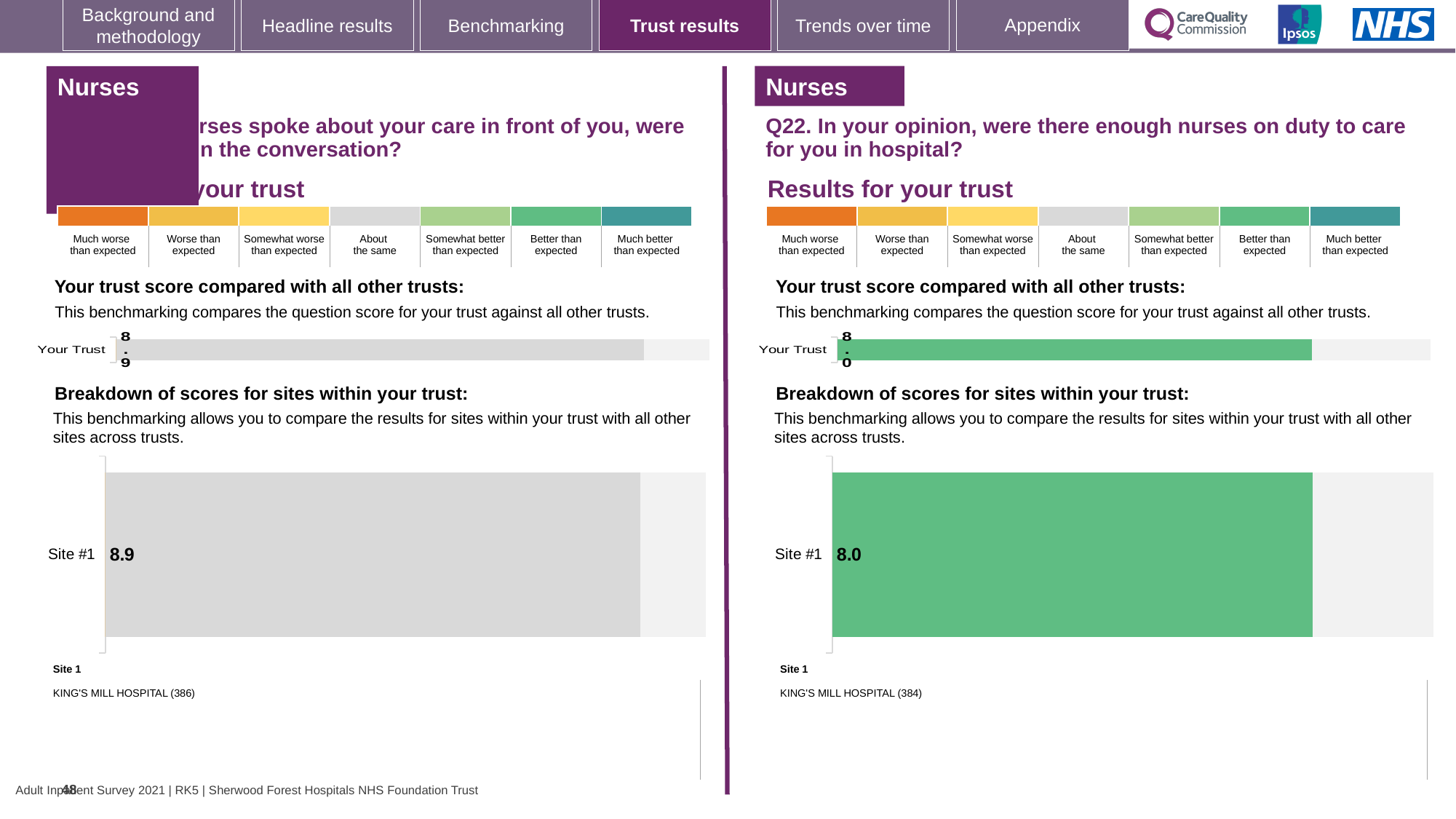
On the right half of the slide (Q22), what colour is the Site #1 bar? Green What kind of chart is used to show the Site #1 score on the right half of the slide (Q22)? Bar chart On the left half of the slide, what score is shown for Site #1 in the 'Breakdown of scores for sites within your trust' chart? 8.9 Which site name is listed as Site 1 under the chart on the right half of the slide (Q22)? KING'S MILL HOSPITAL (384) How many sites are shown in the 'Breakdown of scores for sites within your trust' chart on the right half of the slide (Q22)? 1 What is the difference between the Site #1 score on the left half of the slide (8.9) and the Site #1 score on the right half (8.0)? 0.9 Which site name is listed as Site 1 under the chart on the left half of the slide? KING'S MILL HOSPITAL (386) On the right half of the slide (Q22), what score is shown for Site #1 in the 'Breakdown of scores for sites within your trust' chart? 8.0 On the left half of the slide, what colour is the Your Trust bar? Grey On the right half of the slide (Q22), what is the score shown for Your Trust in the 'Your trust score compared with all other trusts' chart? 8.0 Which is larger: the Site #1 score on the left half of the slide or the Site #1 score on the right half (Q22)? Left half (8.9) On the left half of the slide, what is the score shown for Your Trust in the 'Your trust score compared with all other trusts' chart? 8.9